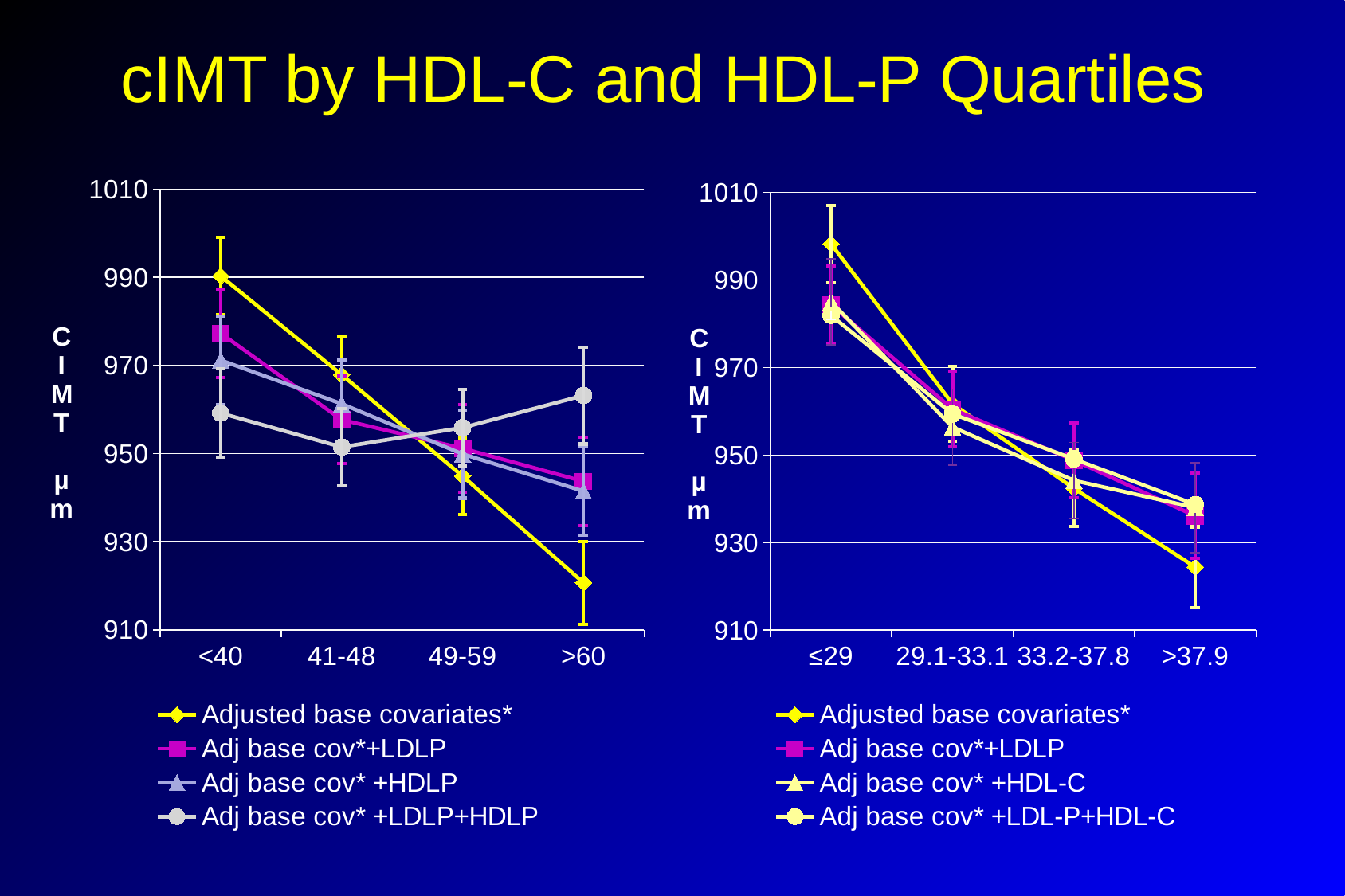
In the left chart, is the 'Adjusted base covariates*' value for >60 greater or less than 930? less What is the y-axis label on both charts? CIMT µm In the right chart, is the 'Adjusted base covariates*' value for ≤29 greater or less than 990? greater In the left chart, which category has the highest value for the 'Adjusted base covariates*' series? <40 In the left chart, which category has the lowest value for the 'Adjusted base covariates*' series? >60 In the right chart at ≤29, which series has the larger value: 'Adjusted base covariates*' or 'Adj base cov* +LDL-P+HDL-C'? Adjusted base covariates* What kind of chart is the left chart (HDL-C quartiles)? line chart How many series does the legend of the left chart list? 4 In the right chart, is the 'Adjusted base covariates*' value for >37.9 greater or less than 930? less In the right chart, does the 'Adjusted base covariates*' series rise or fall from ≤29 to >37.9? fall How many quartile categories are shown on the x axis of the right chart? 4 In the left chart at >60, which series has the larger value: 'Adjusted base covariates*' or 'Adj base cov* +LDLP+HDLP'? Adj base cov* +LDLP+HDLP